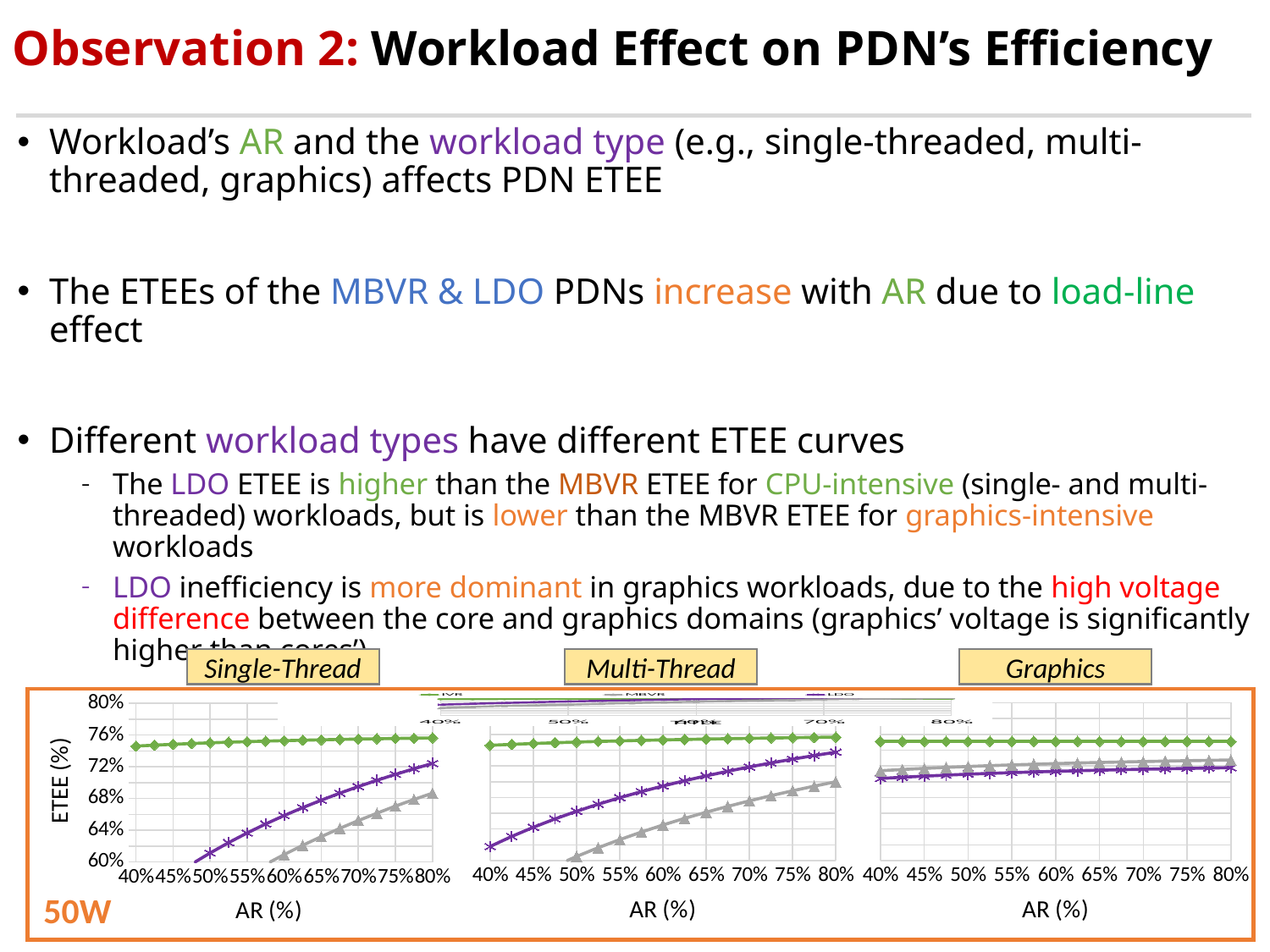
In the Multi-Thread chart, does the MBVR ETEE rise or fall as AR increases? rise In the Single-Thread chart, which is higher at 80% AR, LDO or MBVR? LDO In the Single-Thread chart, is the IVR value at 40% AR greater or less than 72%? greater In the Single-Thread chart, is the LDO value at 80% AR greater or less than 76%? less How many charts are shown in the boxed area at the bottom of the slide? 3 In the Graphics chart, is the LDO value at 40% AR greater or less than 68%? greater In the Single-Thread chart, does the LDO ETEE rise or fall as AR increases from 40% to 80%? rise In the Graphics chart, which is higher at 80% AR, IVR or LDO? IVR What kind of chart is the Single-Thread chart? line chart What is the label on the y axis of the charts? ETEE (%) How many series does the legend above the charts list? 3